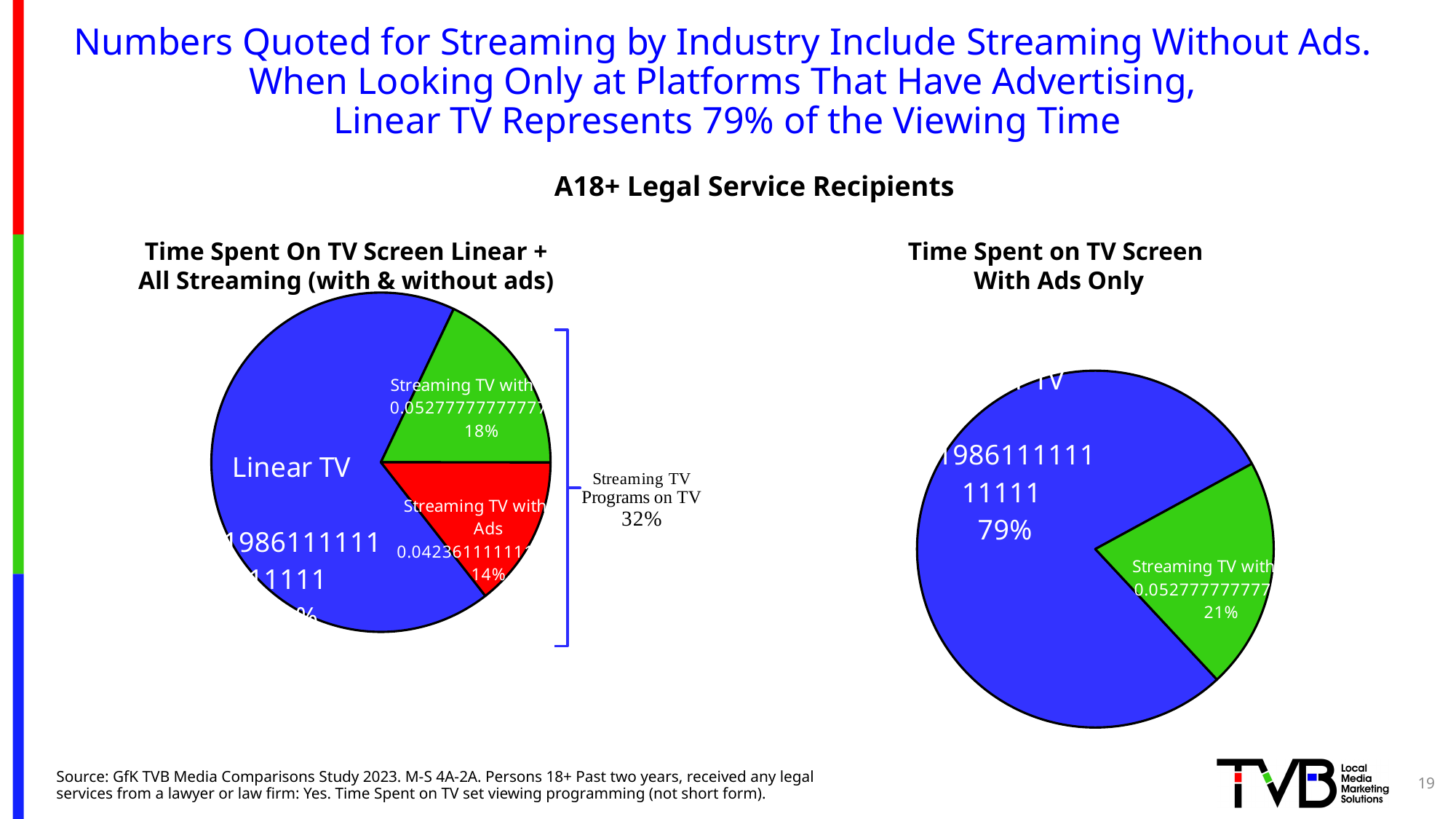
In the right pie chart ('With Ads Only'), how many percentage points larger is Linear TV's share than the streaming slice's share? 58 percentage points What type of chart is used on this slide? Pie chart In the left pie chart, which slice is larger: the green streaming slice or the red 'Streaming TV with Ads' slice? The green streaming slice How many slices does the left pie chart ('Linear + All Streaming') have? 3 In the 'Time Spent on TV Screen With Ads Only' pie chart, which category has the largest share? Linear TV In the left pie chart ('Linear + All Streaming'), what percentage is shown on the green streaming slice? 18% In the 'Time Spent on TV Screen With Ads Only' pie chart, what percentage is shown on the green streaming slice? 21% In the 'Time Spent on TV Screen With Ads Only' pie chart, what share of viewing time does Linear TV represent? 79% How many slices does the right pie chart ('With Ads Only') have? 2 In the left pie chart, what combined percentage does the bracket label give for 'Streaming TV Programs on TV'? 32% In the left pie chart ('Linear + All Streaming'), what percentage is shown for the red 'Streaming TV with Ads' slice? 14% What audience subtitle appears above the two pie charts? A18+ Legal Service Recipients